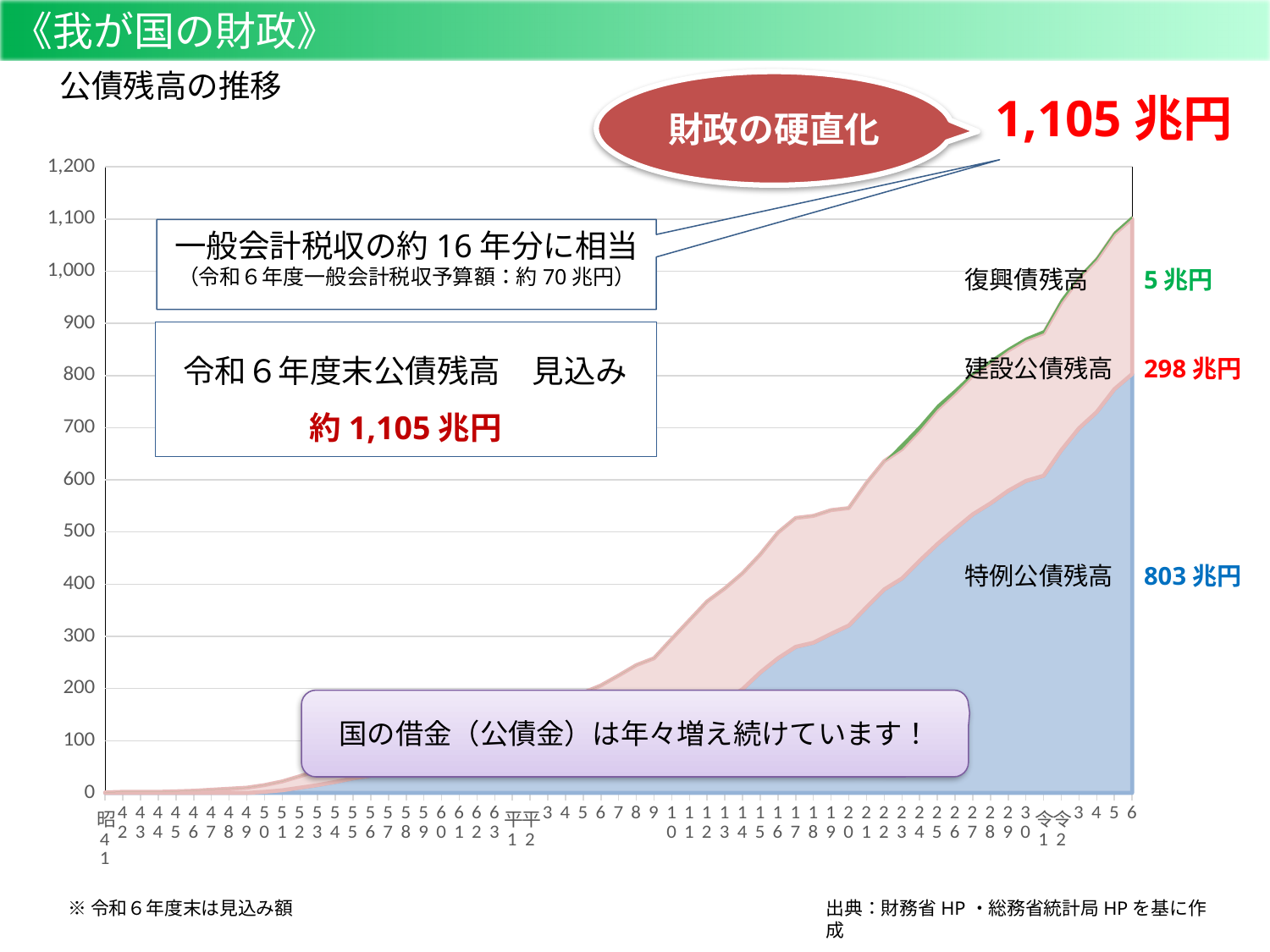
What kind of chart is shown on the slide? Stacked area chart How many bond categories are labelled on the chart? 3 Which is larger at the right end of the chart, 建設公債残高 or 復興債残高? 建設公債残高 What is the value shown for 建設公債残高 at the right end of the chart? 298 兆円 Which bond category has the smallest outstanding balance at the right end of the chart? 復興債残高 What is the value shown for 復興債残高 at the right end of the chart? 5 兆円 What is the value shown for 特例公債残高 at the right end of the chart? 803 兆円 What is the difference between 特例公債残高 (803 兆円) and 建設公債残高 (298 兆円)? 505 兆円 Which bond category has the largest outstanding balance at the right end of the chart? 特例公債残高 What total 公債残高 is shown for 令和6年度末? 1,105 兆円 Do the values rise or fall along the x axis from 昭和41 to 令和6? Rise What is the title of the chart? 公債残高の推移